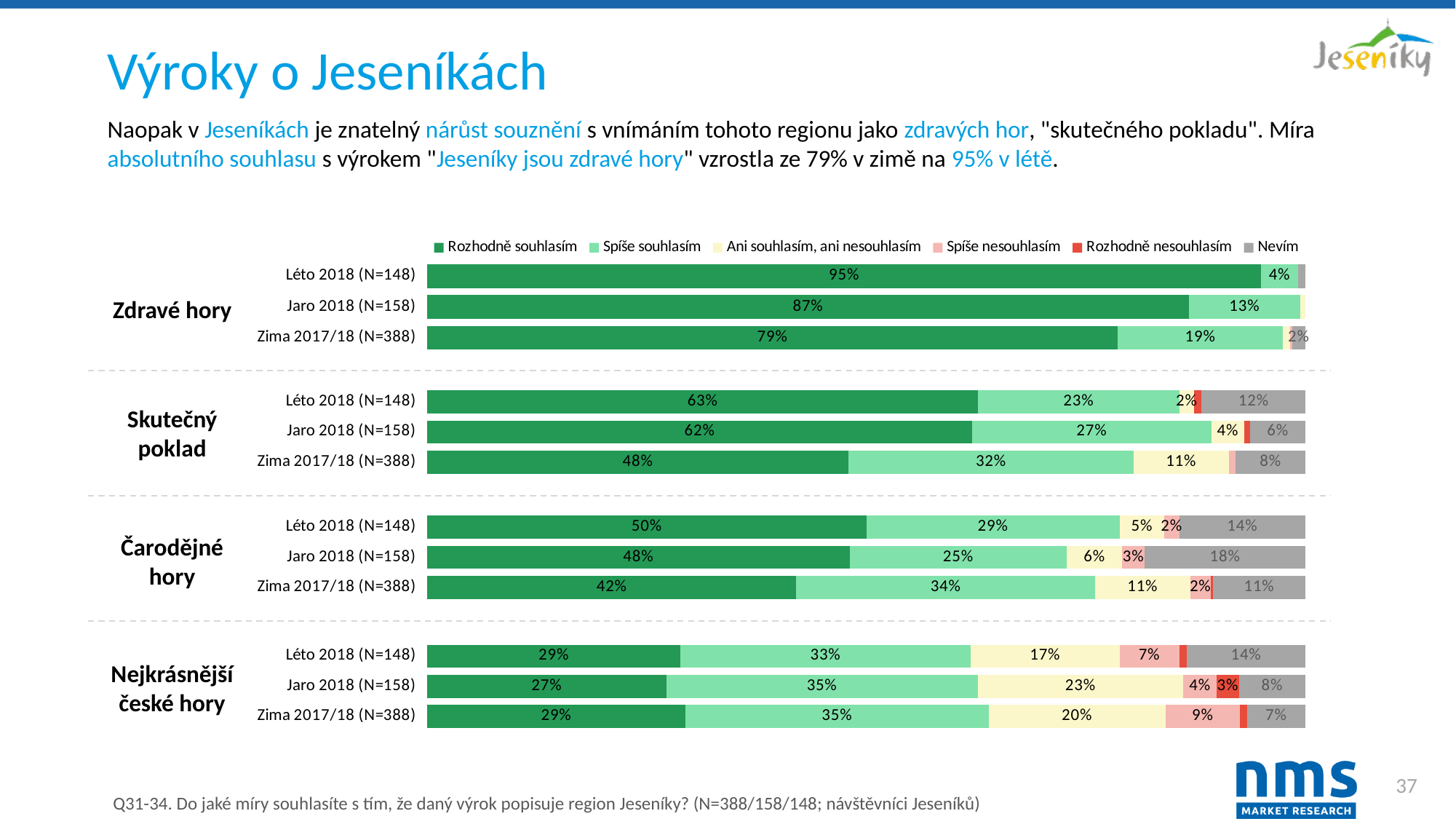
What is the 'Rozhodně souhlasím' value for 'Zdravé hory' in Léto 2018 (N=148)? 95% What is the 'Nevím' value for 'Čarodějné hory' in Jaro 2018 (N=158)? 18% By how many percentage points did 'Rozhodně souhlasím' for 'Zdravé hory' increase from Zima 2017/18 to Léto 2018? 16 percentage points How many statements (row groups) are shown in the chart? 4 What is the 'Ani souhlasím, ani nesouhlasím' value for 'Nejkrásnější české hory' in Jaro 2018 (N=158)? 23% For 'Čarodějné hory', does the 'Rozhodně souhlasím' value rise or fall from Zima 2017/18 through Jaro 2018 to Léto 2018? Rises For 'Skutečný poklad', is the 'Rozhodně souhlasím' value larger in Léto 2018 or in Zima 2017/18? Léto 2018 How many series does the legend list? 6 Across all bars, which statement and period has the highest 'Rozhodně souhlasím' value? Zdravé hory, Léto 2018 (N=148) What kind of chart is shown on the slide? Stacked bar chart What is the 'Spíše souhlasím' value for 'Skutečný poklad' in Zima 2017/18 (N=388)? 32% Within 'Nejkrásnější české hory', which period has the lowest 'Rozhodně souhlasím' value? Jaro 2018 (N=158)